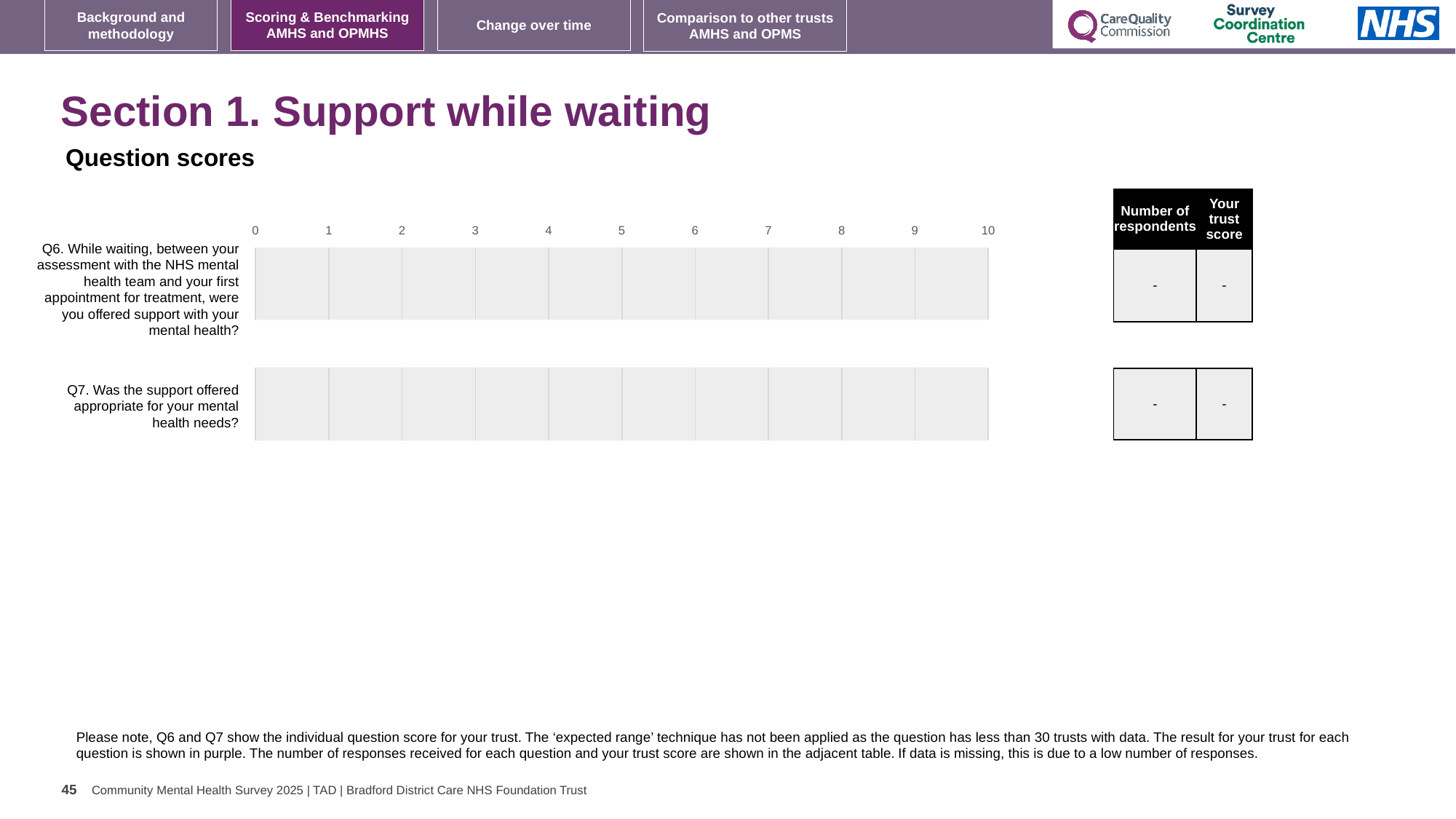
How many questions (categories) are listed on the chart? 2 What is the highest value shown on the chart's axis? 10 What is shown in the 'Your trust score' cell for Q6? - Which question number is listed second on the chart? Q7 What kind of chart is used to show the question scores? bar chart Which question number is listed first on the chart? Q6 What is shown in the 'Number of respondents' cell for Q7? - What is the lowest value shown on the chart's axis? 0